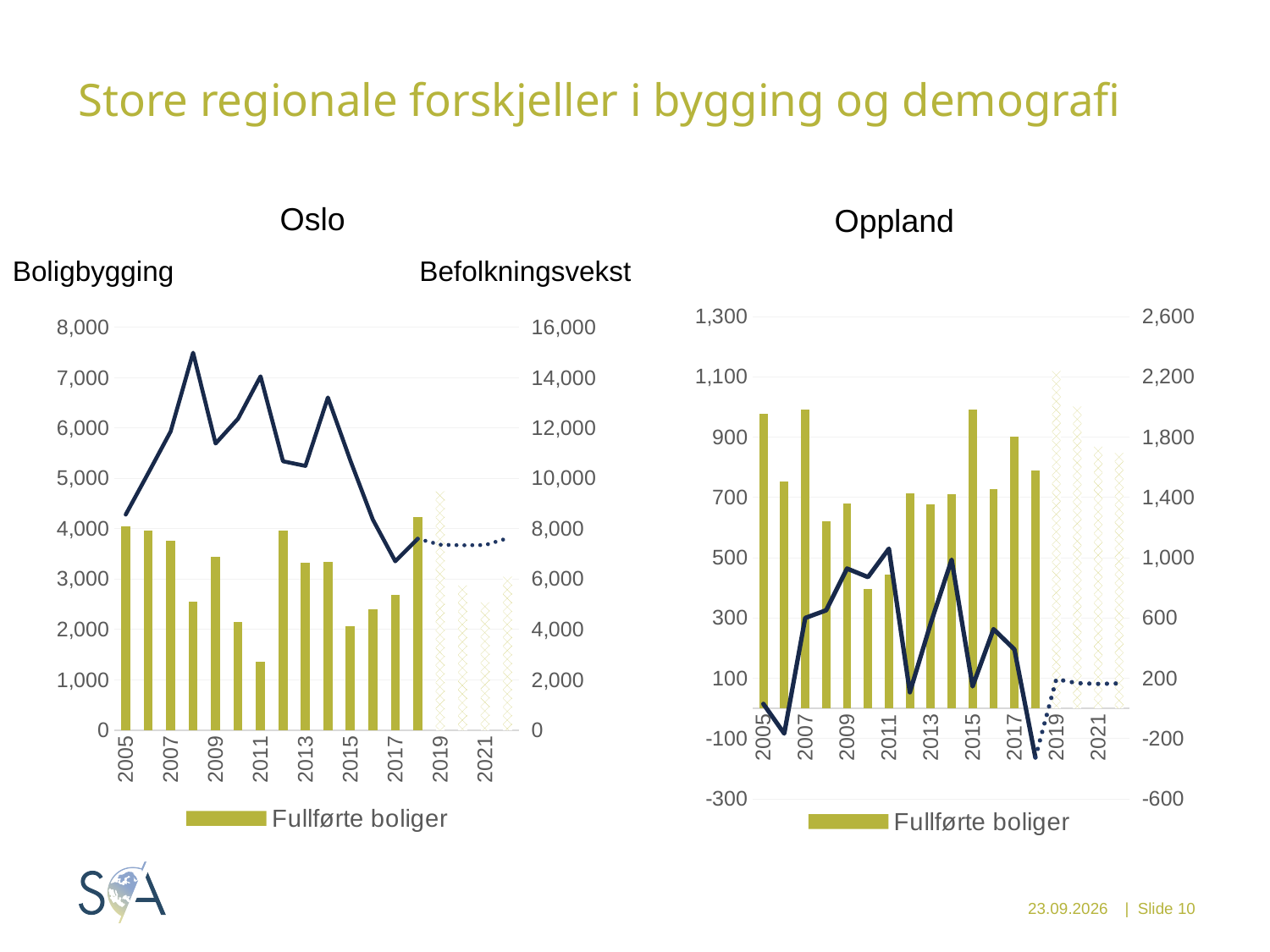
In the Oslo chart, is the Fullførte boliger bar for 2011 greater or less than 2,000? less In the Oslo chart, which is larger, the Fullførte boliger bar for 2005 or for 2011? 2005 How many entries does the legend of the Oslo chart list? 1 In the Oppland chart, is the Fullførte boliger bar for 2017 greater or less than 700? greater In the Oppland chart, is the Fullførte boliger bar for 2010 greater or less than 500? less In the Oppland chart, which is larger, the Fullførte boliger bar for 2005 or for 2010? 2005 What is the title of the slide? Store regionale forskjeller i bygging og demografi What kind of chart is the Oppland chart? Combined bar and line chart In the Oslo chart, which year has the lowest bar for Fullførte boliger among the solid bars? 2011